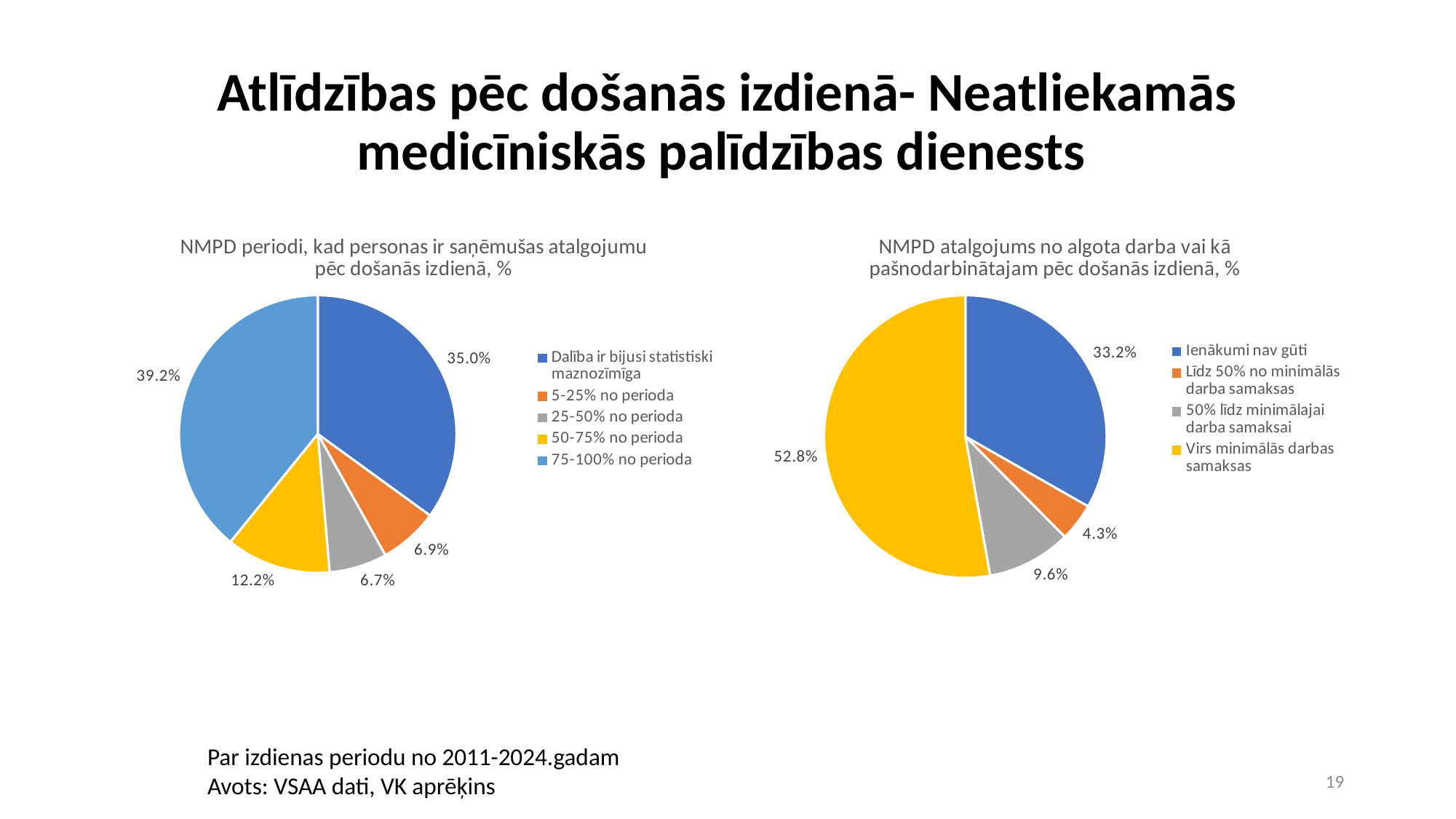
What type of chart is shown on the right side of the slide? Pie chart In the left pie chart, what share is labelled for the '75-100% no perioda' slice? 39.2% How many slices does the left pie chart have? 5 How many categories does the legend of the right pie chart list? 4 In the left pie chart, what is the difference between the '75-100% no perioda' slice and the 'Dalība ir bijusi statistiski maznozīmīga' slice? 4.2% In the left pie chart, which category has the smallest slice? 25-50% no perioda In the right pie chart, what share is labelled for 'Ienākumi nav gūti'? 33.2% In the right pie chart, which is larger: '50% līdz minimālajai darba samaksai' or 'Līdz 50% no minimālās darba samaksas'? 50% līdz minimālajai darba samaksai In the left pie chart, which category has the largest slice? 75-100% no perioda In the left pie chart, what share is labelled for the '50-75% no perioda' slice? 12.2% In the right pie chart, which category has the smallest slice? Līdz 50% no minimālās darba samaksas In the right pie chart, what share is labelled for 'Virs minimālās darbas samaksas'? 52.8%